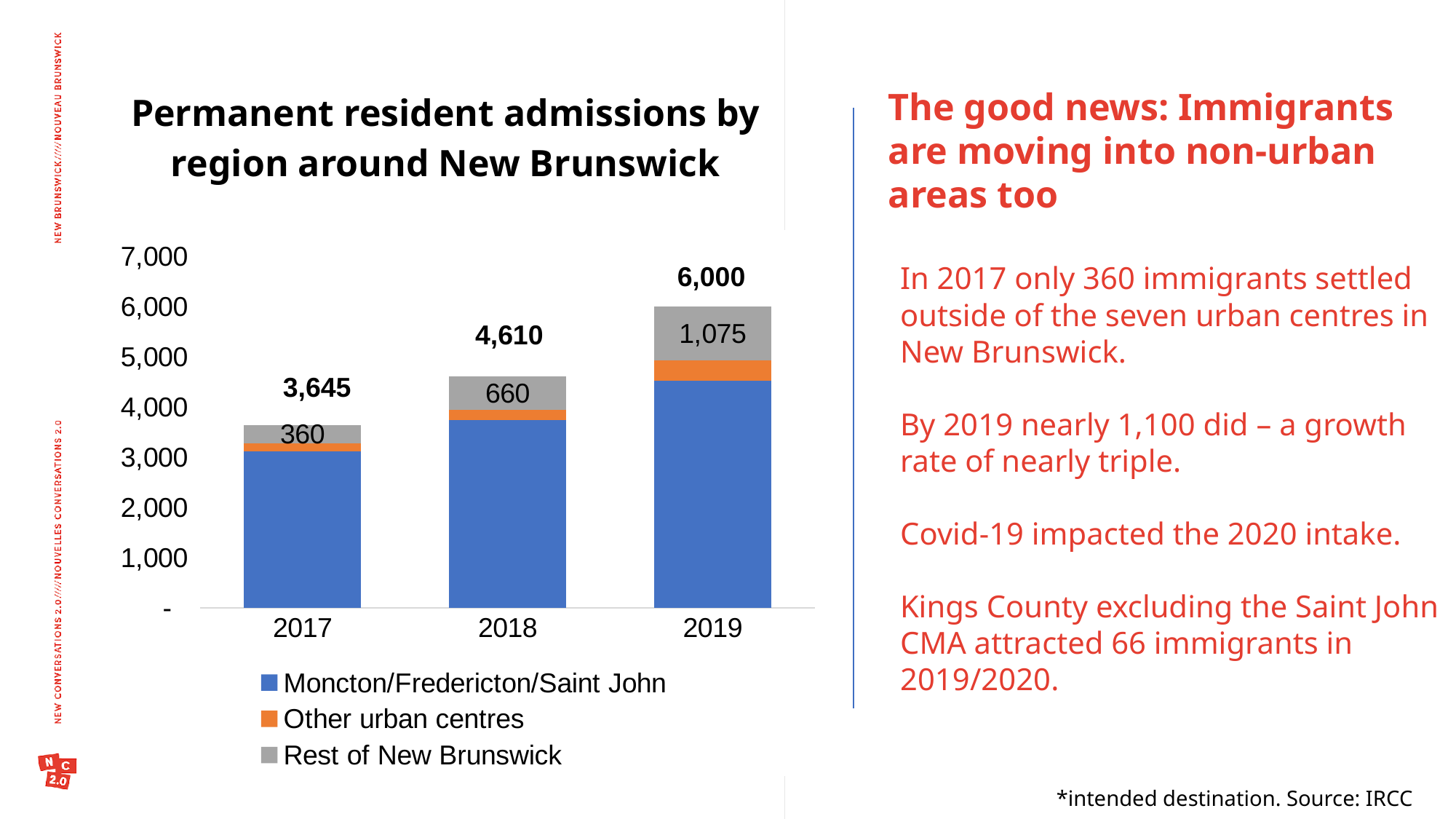
What is the value for Rest of New Brunswick in 2019? 1,075 What is the difference between the total admissions in 2019 and 2017? 2,355 What is the total permanent resident admissions shown for 2017? 3,645 What is the total permanent resident admissions shown for 2019? 6,000 Is the total for 2018 larger or smaller than the total for 2019? smaller Do the total admissions rise or fall from 2017 to 2019? rise Which year has the lowest value for Rest of New Brunswick? 2017 Is the value for Moncton/Fredericton/Saint John in 2019 greater or less than 4,000? greater Which year has the highest total permanent resident admissions? 2019 How much larger is the Rest of New Brunswick value in 2019 than in 2017? 715 What is the value for Rest of New Brunswick in 2018? 660 How many series does the legend list? 3